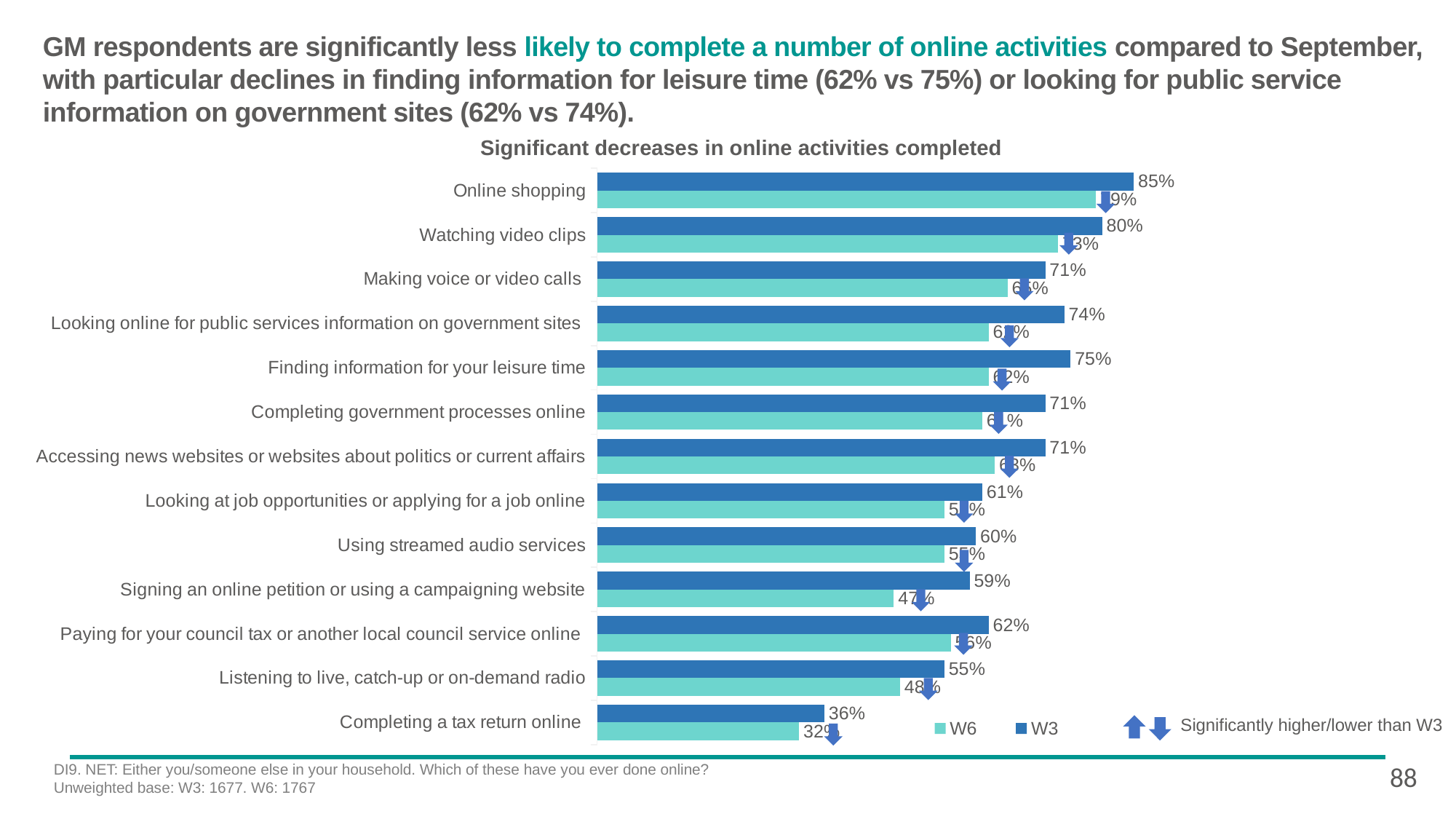
What is the W3 value for Completing a tax return online? 36% How many series does the legend list? 2 How many online activities are listed in the chart? 13 What type of chart is shown on the slide? Bar chart Which activity has the lowest W3 value? Completing a tax return online What is the difference between the W3 and W6 values for Finding information for your leisure time? 13 percentage points What is the W3 value for Online shopping? 85% What is the W6 value for Signing an online petition or using a campaigning website? 47% Which activity has the highest W3 value? Online shopping What is the W6 value for Listening to live, catch-up or on-demand radio? 48% Which has the larger W3 value: Watching video clips or Making voice or video calls? Watching video clips What is the difference between the W3 and W6 values for Completing a tax return online? 4 percentage points